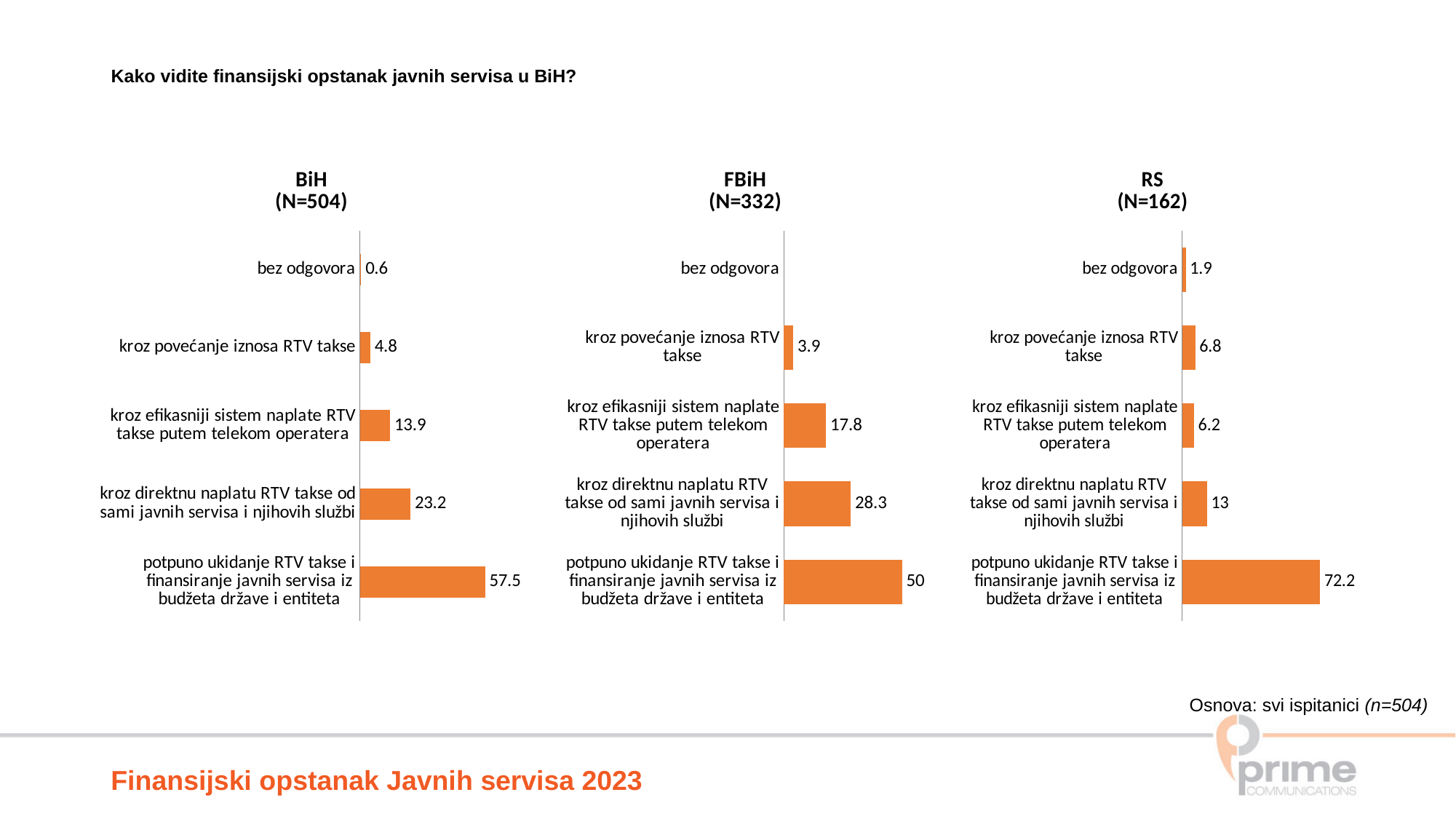
In the RS (N=162) chart, which category has the highest value? potpuno ukidanje RTV takse i finansiranje javnih servisa iz budžeta države i entiteta In the BiH (N=504) chart, what is the value for "potpuno ukidanje RTV takse i finansiranje javnih servisa iz budžeta države i entiteta"? 57.5 In the RS (N=162) chart, what is the value for "bez odgovora"? 1.9 In the RS (N=162) chart, which is larger: "kroz efikasniji sistem naplate RTV takse putem telekom operatera" or "kroz direktnu naplatu RTV takse od sami javnih servisa i njihovih službi"? kroz direktnu naplatu RTV takse od sami javnih servisa i njihovih službi In the RS (N=162) chart, what is the value for "kroz povećanje iznosa RTV takse"? 6.8 How many charts are shown on the slide? 3 What type of chart is the FBiH (N=332) chart? bar chart In the BiH (N=504) chart, which category has the lowest value? bez odgovora How many categories are shown in the BiH (N=504) chart? 5 In the BiH (N=504) chart, what is the difference between "kroz direktnu naplatu RTV takse od sami javnih servisa i njihovih službi" and "kroz efikasniji sistem naplate RTV takse putem telekom operatera"? 9.3 In the FBiH (N=332) chart, what is the difference between "potpuno ukidanje RTV takse i finansiranje javnih servisa iz budžeta države i entiteta" and "kroz direktnu naplatu RTV takse od sami javnih servisa i njihovih službi"? 21.7 In the FBiH (N=332) chart, what is the value for "kroz direktnu naplatu RTV takse od sami javnih servisa i njihovih službi"? 28.3